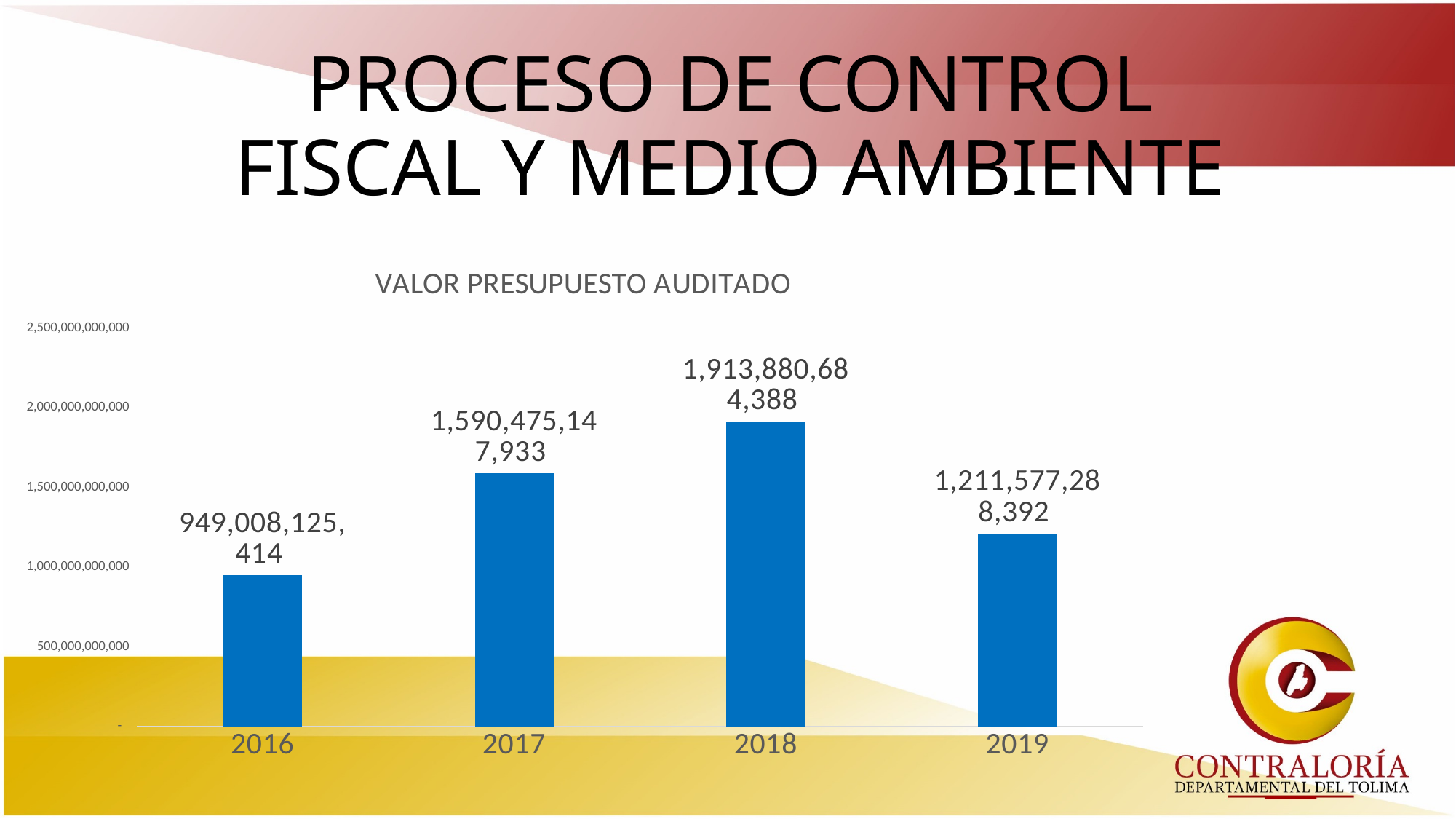
What is the value for 2019? 1,211,577,288,392 What is the title of the chart? VALOR PRESUPUESTO AUDITADO Which year has the highest value? 2018 Which is larger, the value for 2019 or the value for 2017? 2017 Is the value for 2016 greater or less than 1,000,000,000,000? less What is the value for 2018? 1,913,880,684,388 What is the value for 2016? 949,008,125,414 What is the value for 2017? 1,590,475,147,933 Which year has the lowest value? 2016 How many years are shown on the x axis? 4 What type of chart is shown on the slide? Bar chart What is the difference between the values for 2018 and 2017? 323,405,536,455